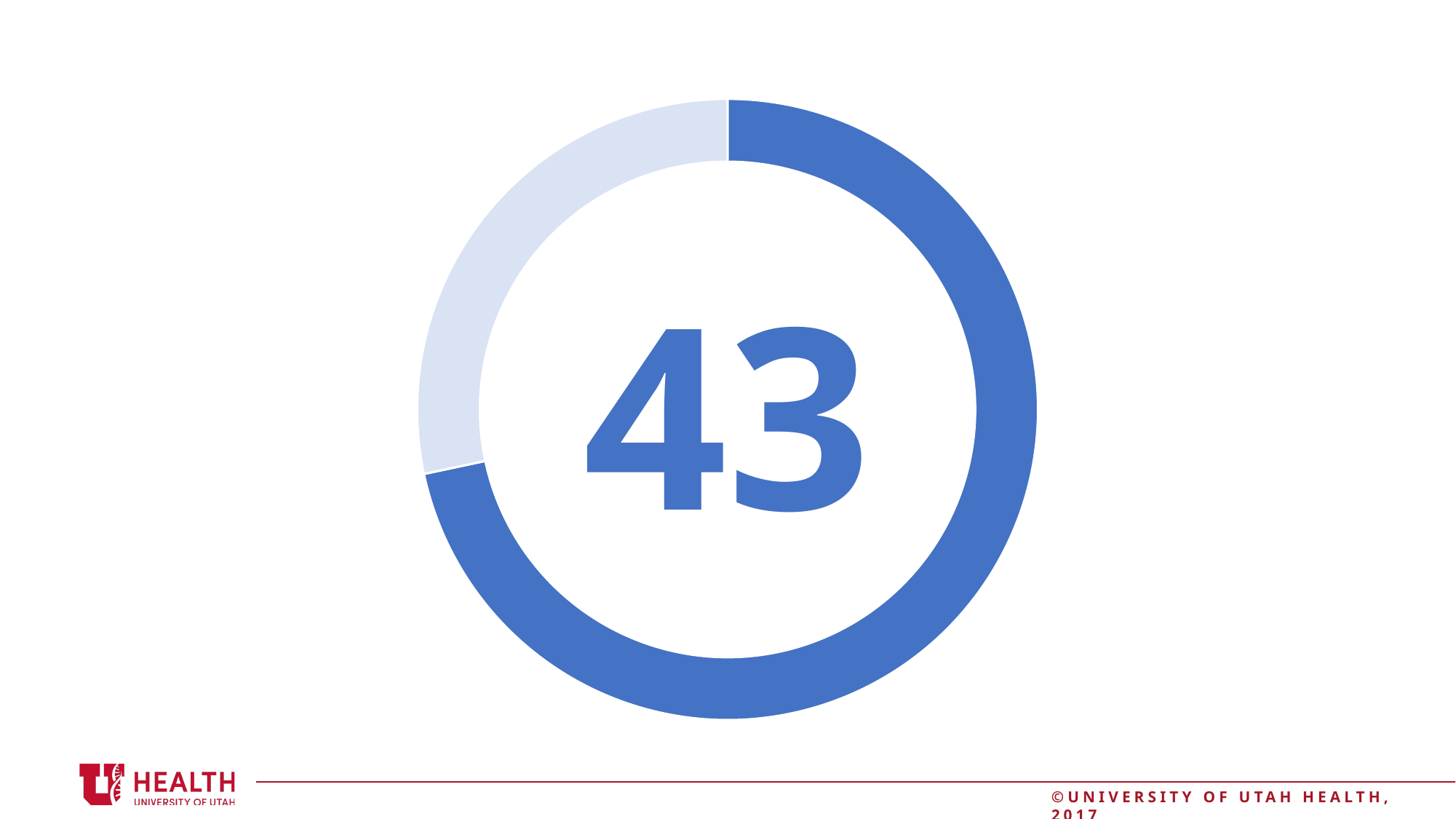
What colour is the smaller segment of the doughnut chart? light blue Which segment of the doughnut chart is larger, the dark blue one or the light blue one? the dark blue one Does the doughnut chart have a legend? No How many segments does the doughnut chart have? 2 What kind of chart is shown on the slide? doughnut chart What number is printed in the centre of the doughnut chart? 43 Does the dark blue segment cover more or less than half of the doughnut ring? more